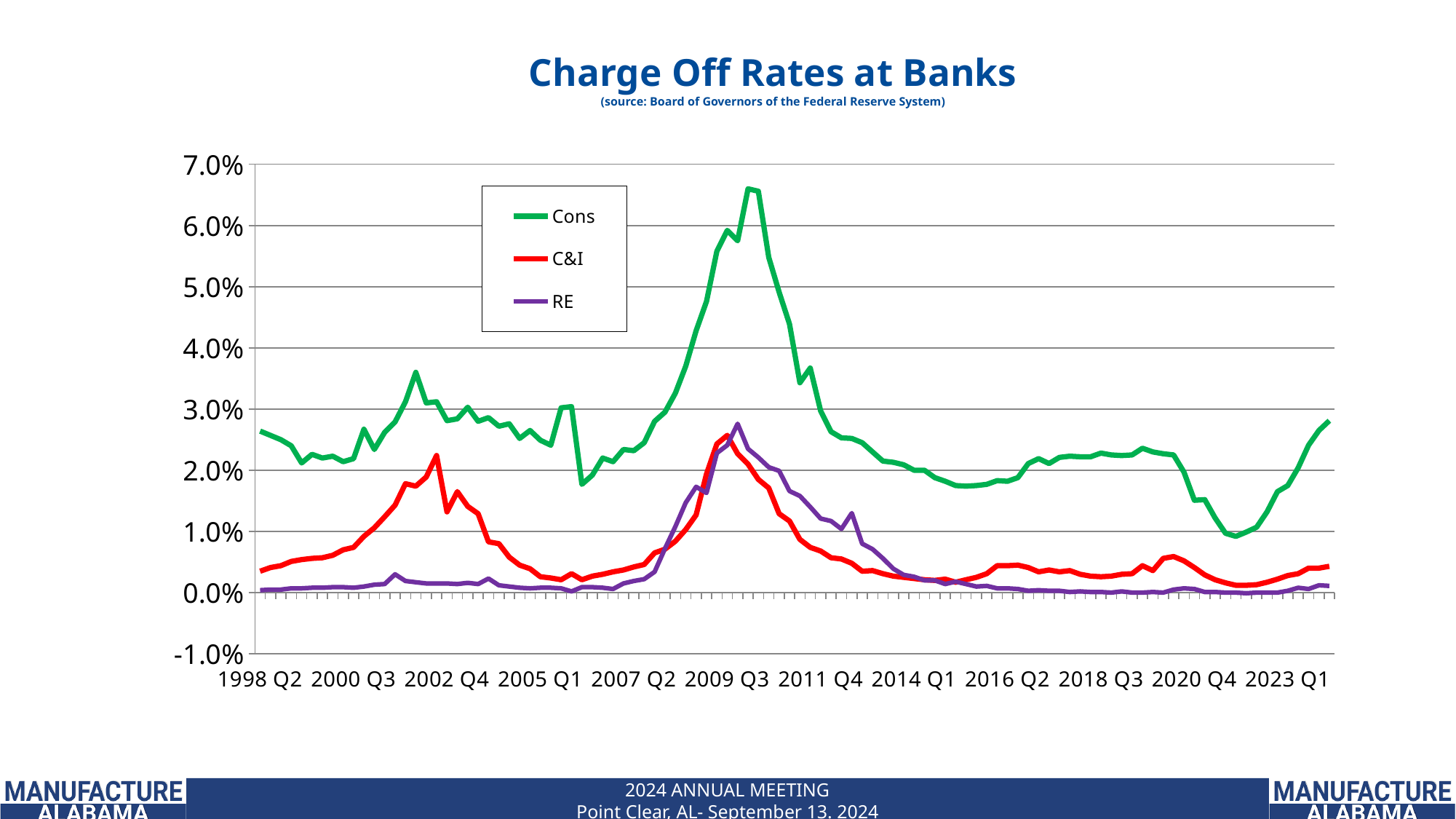
What is the title of the chart? Charge Off Rates at Banks Is the value for C&I at 1998 Q2 greater or less than 1.0%? less Which series has the lowest value at 2023 Q1? RE At 2009 Q3, which is larger, Cons or C&I? Cons Which series reaches the highest value on the chart? Cons How many series does the legend list? 3 Is the value for Cons at 2023 Q1 greater or less than 2.0%? less Is the value for RE at 2014 Q1 greater or less than 1.0%? less What kind of chart is shown on the slide? line chart Which colour is used for the C&I series? red Does the Cons series rise or fall between 2009 Q3 and 2011 Q4? fall